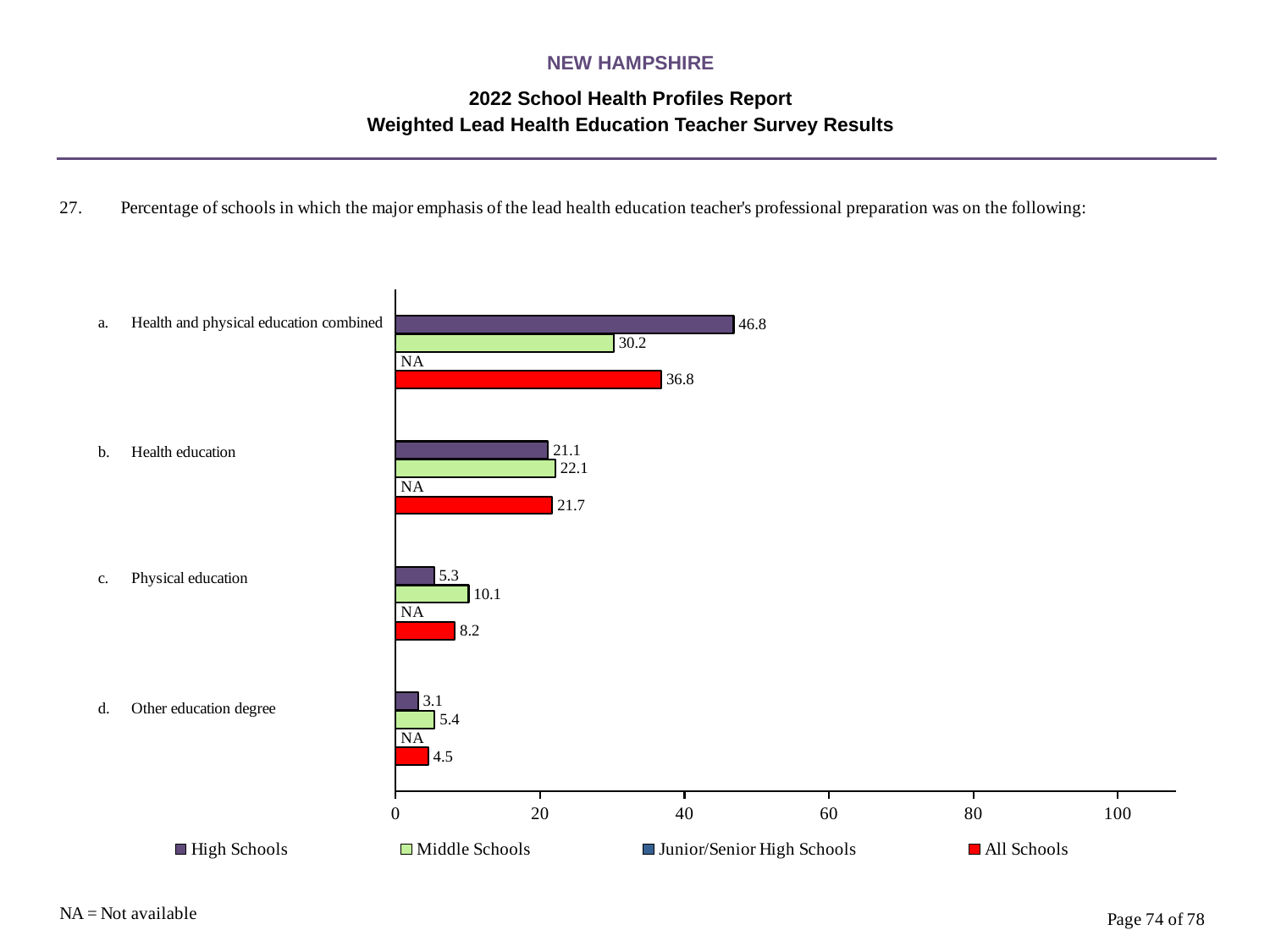
What is the difference between the High Schools and Middle Schools values for 'Health and physical education combined'? 16.6 What is the value for Middle Schools for 'Physical education'? 10.1 How many categories are shown on the chart? 4 What kind of chart is shown on the slide? Bar chart Which category has the highest value for All Schools? Health and physical education combined What is the value for All Schools for 'Health education'? 21.7 Which is larger for 'Health education': the High Schools value or the Middle Schools value? Middle Schools What is the value for High Schools for 'Health and physical education combined'? 46.8 Which category has the lowest value for High Schools? Other education degree What value is shown for Junior/Senior High Schools for 'Other education degree'? NA How many series does the legend list? 4 Is the All Schools value for 'Health and physical education combined' greater or less than 40? less